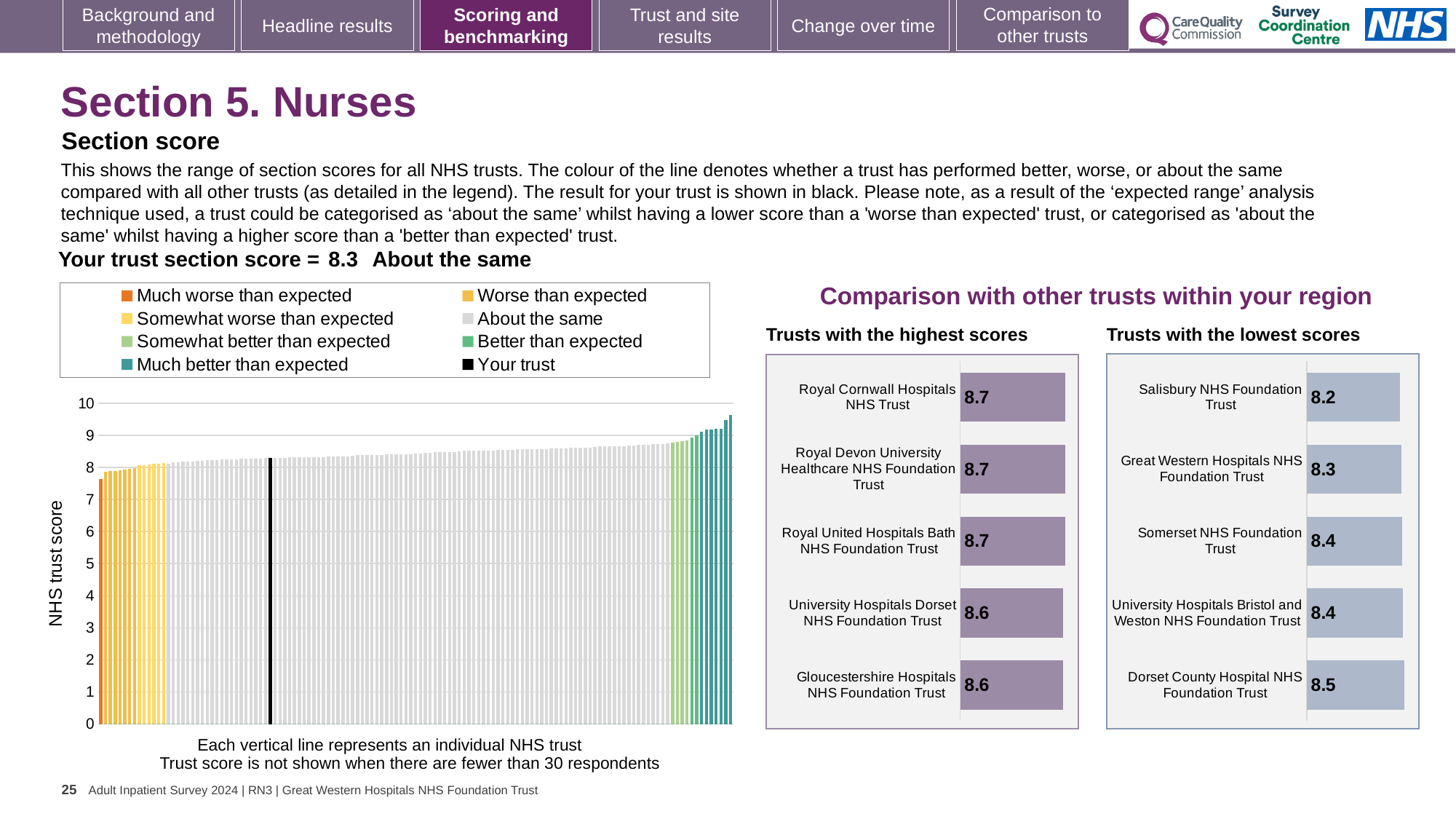
In the 'Trusts with the lowest scores' chart, what is the difference between the scores of Dorset County Hospital NHS Foundation Trust and Salisbury NHS Foundation Trust? 0.3 In the 'Trusts with the lowest scores' chart, which has the higher score: Somerset NHS Foundation Trust or Salisbury NHS Foundation Trust? Somerset NHS Foundation Trust In the 'Trusts with the lowest scores' chart, which trust has the highest score? Dorset County Hospital NHS Foundation Trust In the large 'NHS trust score' chart on the left, what is the section score for your trust (the black bar)? 8.3 In the 'Trusts with the lowest scores' chart, what is the score for Salisbury NHS Foundation Trust? 8.2 In the 'Trusts with the highest scores' chart, what is the difference between the scores of Royal Cornwall Hospitals NHS Trust and Gloucestershire Hospitals NHS Foundation Trust? 0.1 In the 'Trusts with the lowest scores' chart, what is the score for Great Western Hospitals NHS Foundation Trust? 8.3 How many trusts are listed in the 'Trusts with the highest scores' chart? 5 In the 'Trusts with the highest scores' chart, what is the score for Royal Cornwall Hospitals NHS Trust? 8.7 In the 'Trusts with the lowest scores' chart, which trust has the lowest score? Salisbury NHS Foundation Trust What kind of chart is the large 'NHS trust score' chart on the left of the slide? Bar chart How many entries does the legend of the large 'NHS trust score' chart on the left list? 8